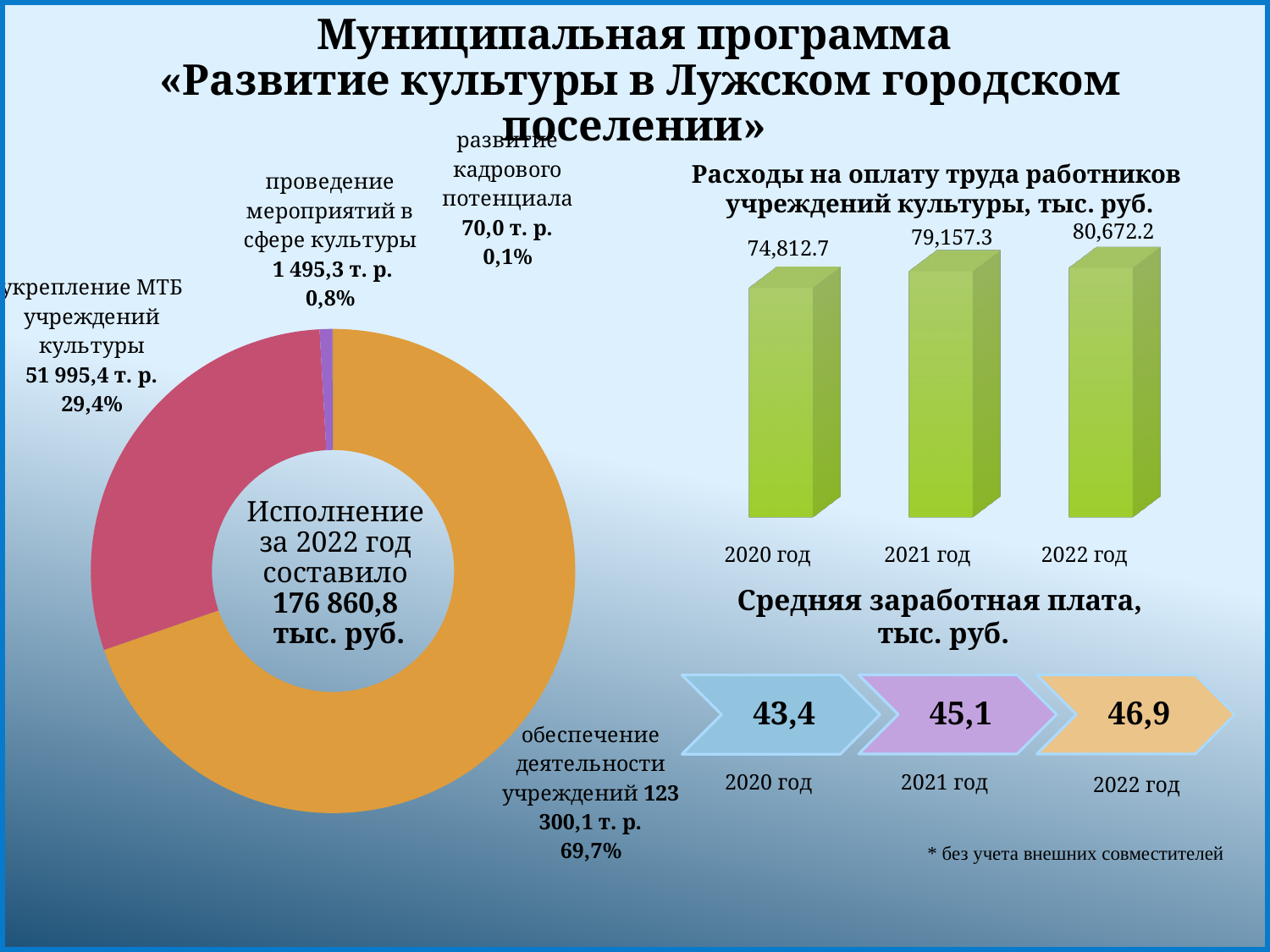
On the donut chart on the left, what share does «обеспечение деятельности учреждений» account for? 69,7% On the chart «Расходы на оплату труда работников учреждений культуры, тыс. руб.», what is the difference between 2022 год and 2020 год? 5,859.5 On the donut chart on the left, what total is shown in the centre for 2022? 176 860,8 тыс. руб. In the «Средняя заработная плата, тыс. руб.» graphic, what is the value for 2021 год? 45,1 On the donut chart on the left, how many categories are shown? 4 What kind of chart is «Расходы на оплату труда работников учреждений культуры, тыс. руб.»? bar chart On the chart «Расходы на оплату труда работников учреждений культуры, тыс. руб.», which year has the highest value? 2022 год On the donut chart on the left, which category has the smallest share? развитие кадрового потенциала On the donut chart on the left, which category has the largest share? обеспечение деятельности учреждений On the chart «Расходы на оплату труда работников учреждений культуры, тыс. руб.», do the values rise or fall from 2020 to 2022? rise On the donut chart on the left, what is the value for «укрепление МТБ учреждений культуры»? 51 995,4 т. р. On the chart «Расходы на оплату труда работников учреждений культуры, тыс. руб.», what is the value for 2021 год? 79,157.3